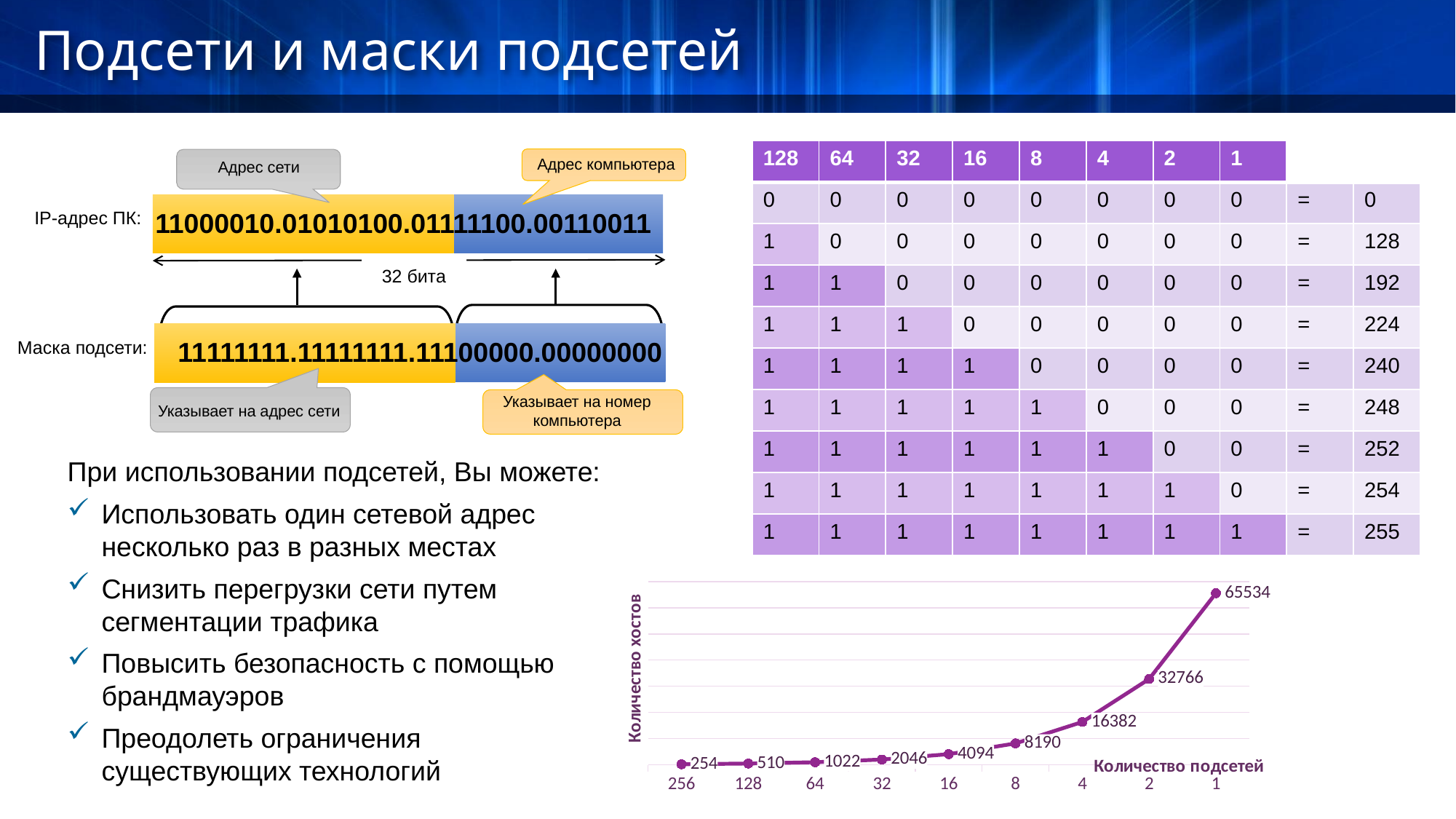
In the line chart, which number of subnets has the highest number of hosts? 1 In the line chart, which has more hosts: 8 subnets or 32 subnets? 8 subnets In the line chart, what is the difference between the number of hosts for 2 subnets and for 4 subnets? 16384 In the line chart, what is the number of hosts when the number of subnets is 4? 16382 What is the label of the vertical axis of the line chart? Количество хостов In the line chart, which number of subnets has the lowest number of hosts? 256 How many data points are plotted in the line chart? 9 In the line chart, what is the number of hosts when the number of subnets is 1? 65534 In the line chart, what is the number of hosts (Количество хостов) when the number of subnets is 256? 254 In the line chart, do the values rise or fall moving from left to right along the x axis? rise In the line chart, what is the number of hosts when the number of subnets is 16? 4094 What kind of chart is shown at the bottom right of the slide? line chart